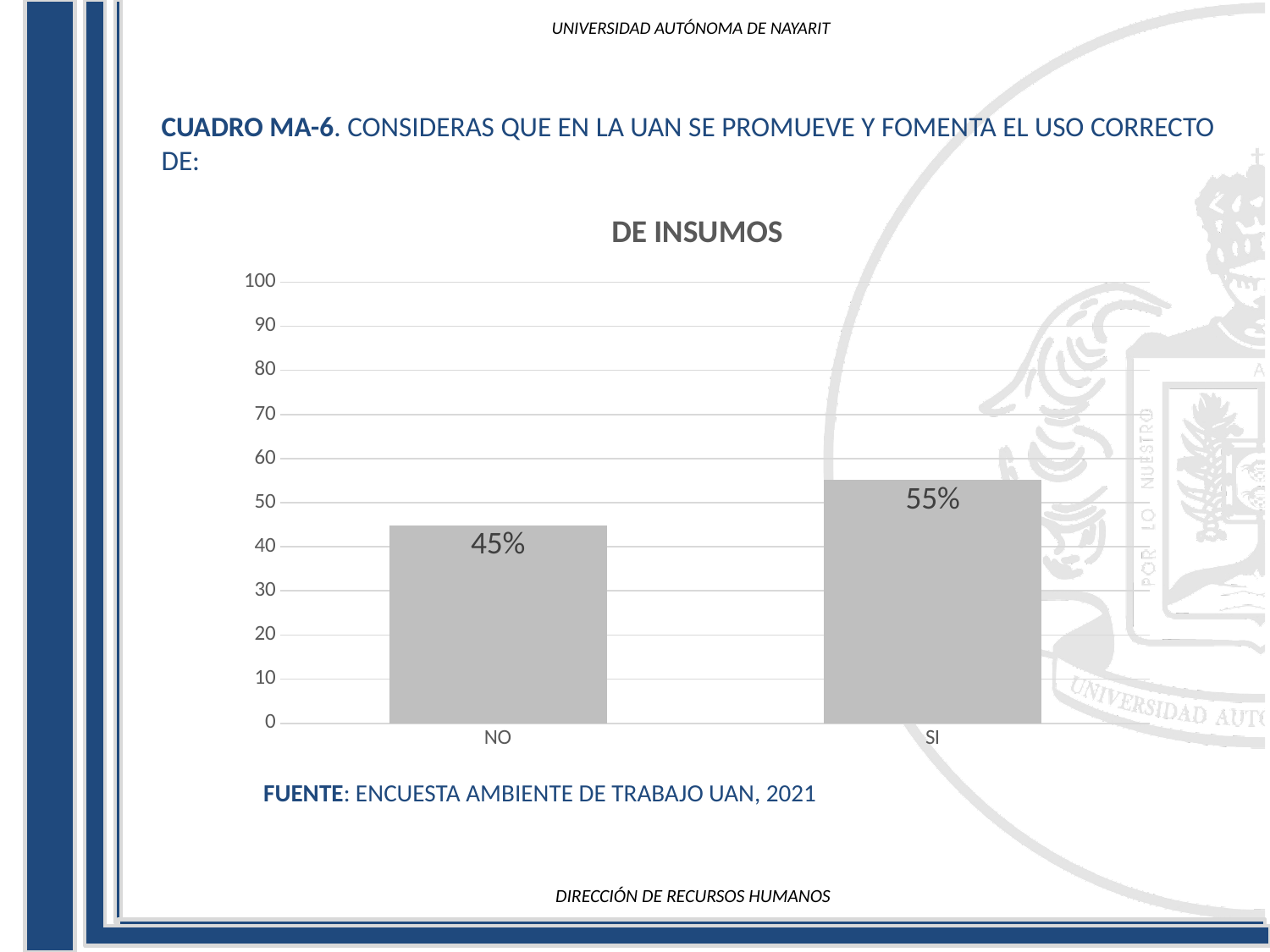
How many categories are shown on the x axis? 2 What is the value for NO? 45% What kind of chart is shown on the slide? bar chart What is the title of the chart? DE INSUMOS Which category has the lowest value? NO Which is larger, the value for NO or the value for SI? SI Which category has the highest value? SI Is the value for NO greater or less than 50? less What is the highest value shown on the vertical axis? 100 What is the difference between the values for SI and NO? 10% Is the value for SI greater or less than 50? greater What is the value for SI? 55%